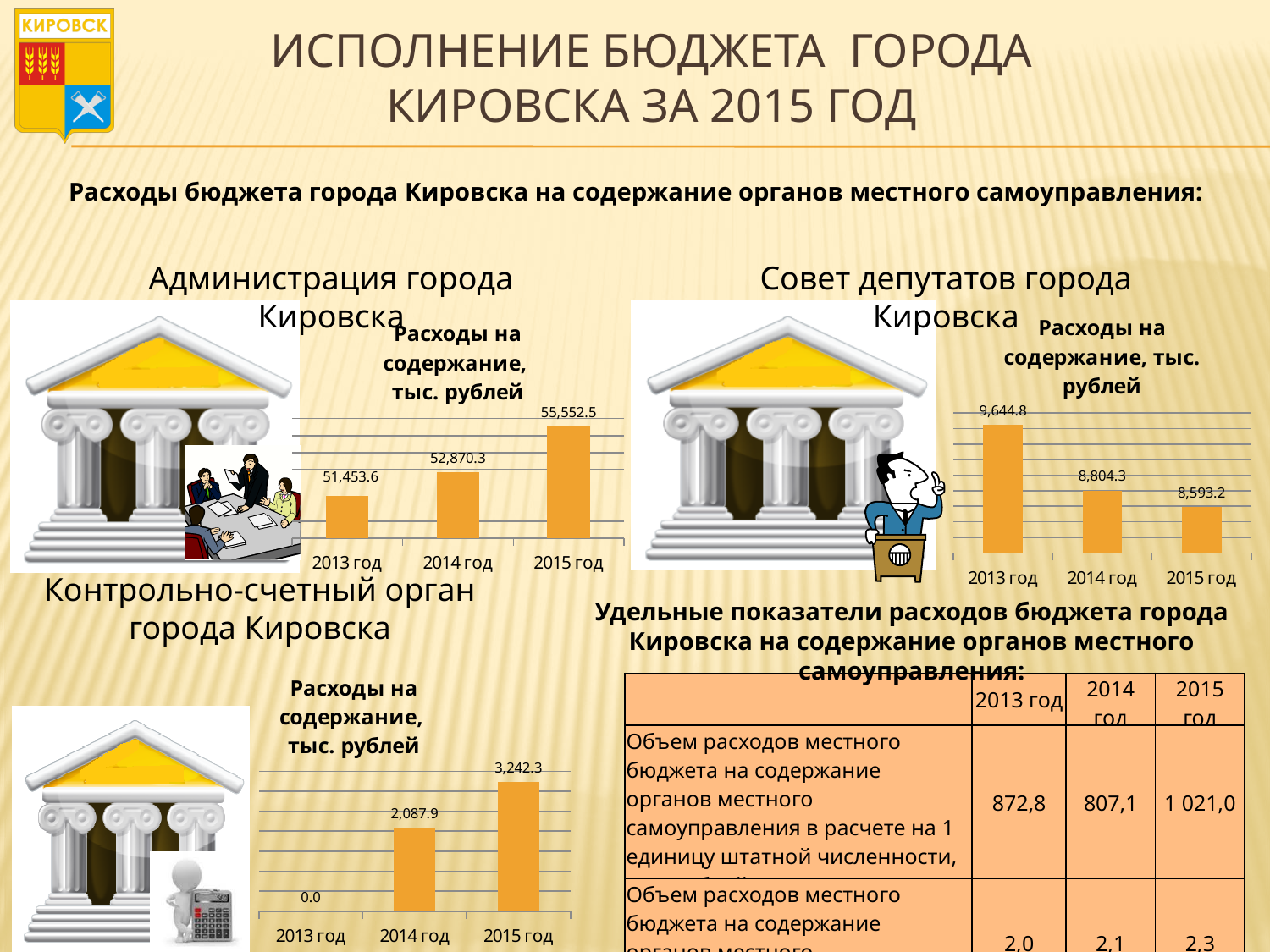
In the Совет депутатов города Кировска chart, what is the value for 2013 год? 9,644.8 How many categories does the Контрольно-счетный орган города Кировска chart show? 3 In the Контрольно-счетный орган города Кировска chart, what is the difference between the 2015 год and 2014 год values? 1,154.4 What type of chart is used for the Администрация города Кировска data? bar chart In the Администрация города Кировска chart, do the values rise or fall from 2013 год to 2015 год? rise In the Совет депутатов города Кировска chart, which year has the highest value? 2013 год In the Совет депутатов города Кировска chart, do the values rise or fall from 2013 год to 2015 год? fall In the Администрация города Кировска chart, what is the difference between the 2015 год and 2014 год values? 2,682.2 In the Администрация города Кировска chart, what is the value for 2015 год? 55,552.5 In the Совет депутатов города Кировска chart, which is larger, the value for 2014 год or 2015 год? 2014 год In the Администрация города Кировска chart, which year has the lowest value? 2013 год In the Контрольно-счетный орган города Кировска chart, what is the value for 2014 год? 2,087.9